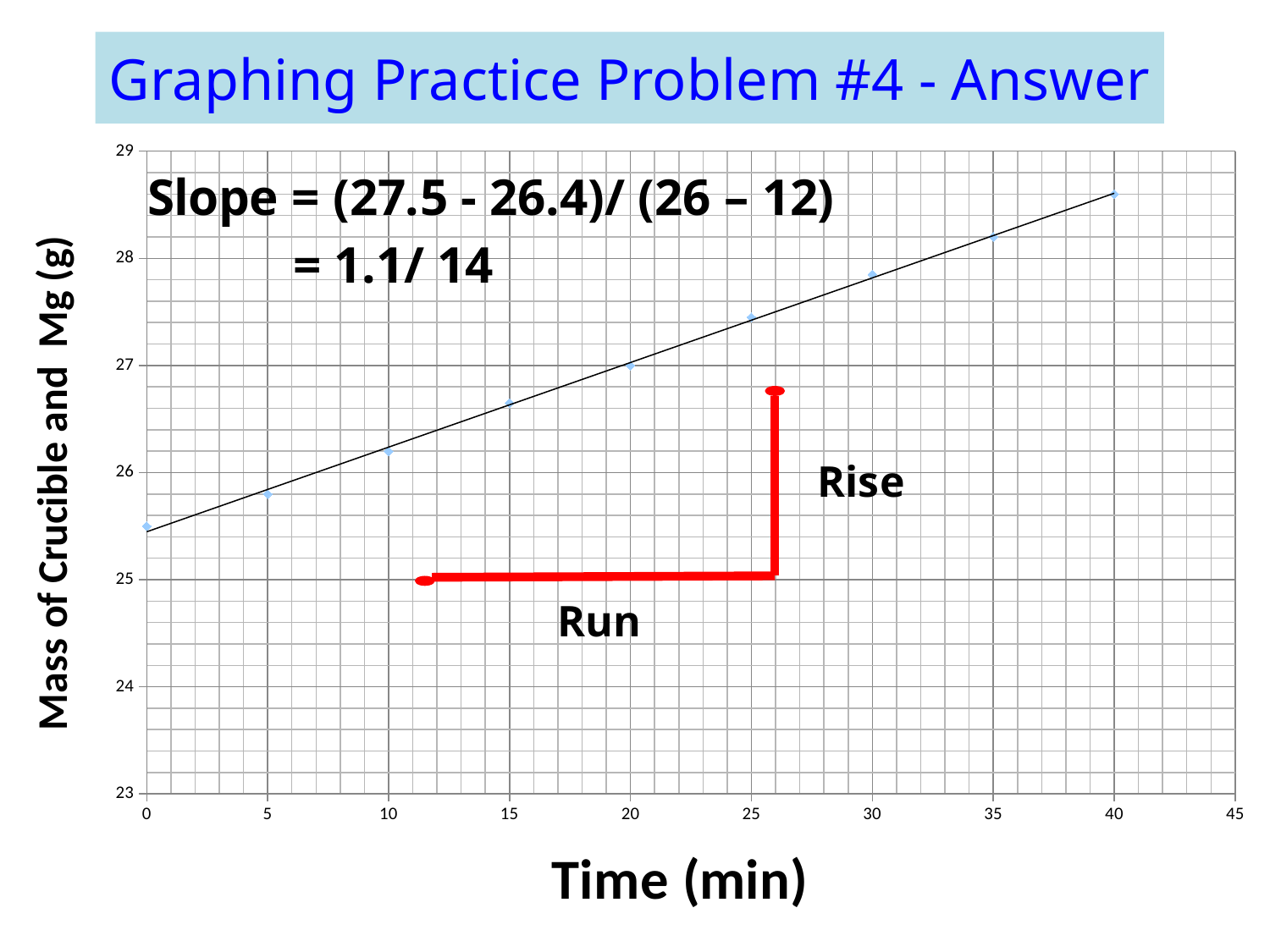
What kind of chart is shown on the slide? scatter plot with a trend line Is the mass at 40 min greater or less than 28 g? greater What is the title of the x axis? Time (min) At which time (min) is the plotted mass highest? 40 Is the mass at 25 min greater or less than 27 g? greater Do the plotted values rise or fall as time increases along the x axis? rise At which time (min) is the plotted mass lowest? 0 Is the mass at 0 min greater or less than 25 g? greater How many data points are plotted on the chart? 9 Which has the larger plotted mass, 10 min or 30 min? 30 min